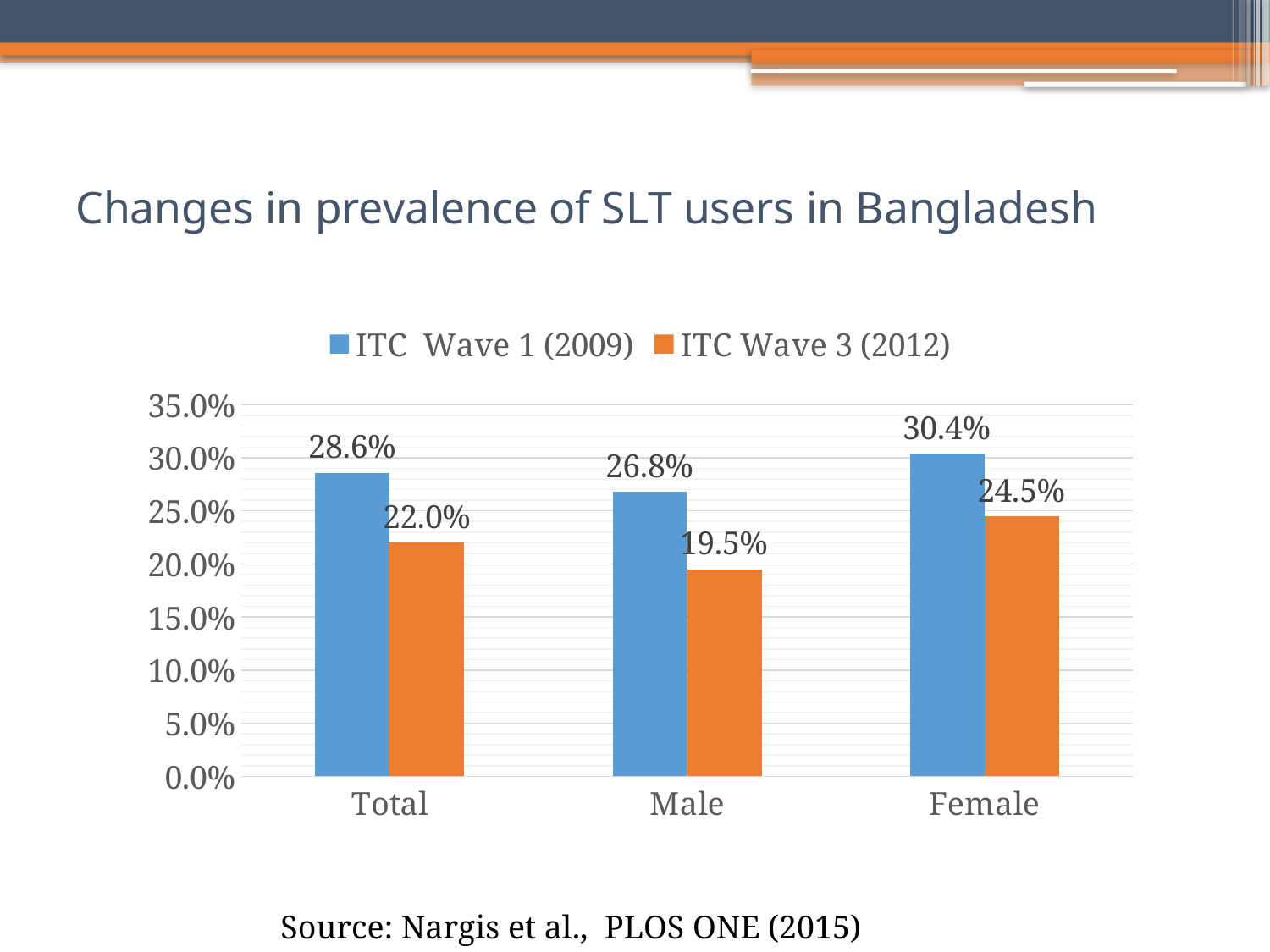
What is the difference between the ITC Wave 1 (2009) and ITC Wave 3 (2012) values for Male? 7.3% How many categories are shown on the x axis? 3 What is the ITC Wave 3 (2012) value for Male? 19.5% Which is larger: the ITC Wave 1 (2009) value for Male or the ITC Wave 3 (2012) value for Female? ITC Wave 1 (2009) value for Male Which category has the lowest ITC Wave 3 (2012) value? Male Which category has the highest ITC Wave 1 (2009) value? Female How many series does the legend list? 2 What is the difference between the Female and Total values for ITC Wave 3 (2012)? 2.5% What is the ITC Wave 1 (2009) value for Total? 28.6% What is the ITC Wave 3 (2012) value for Female? 24.5% What is the title of the slide? Changes in prevalence of SLT users in Bangladesh What kind of chart is shown on the slide? Bar chart